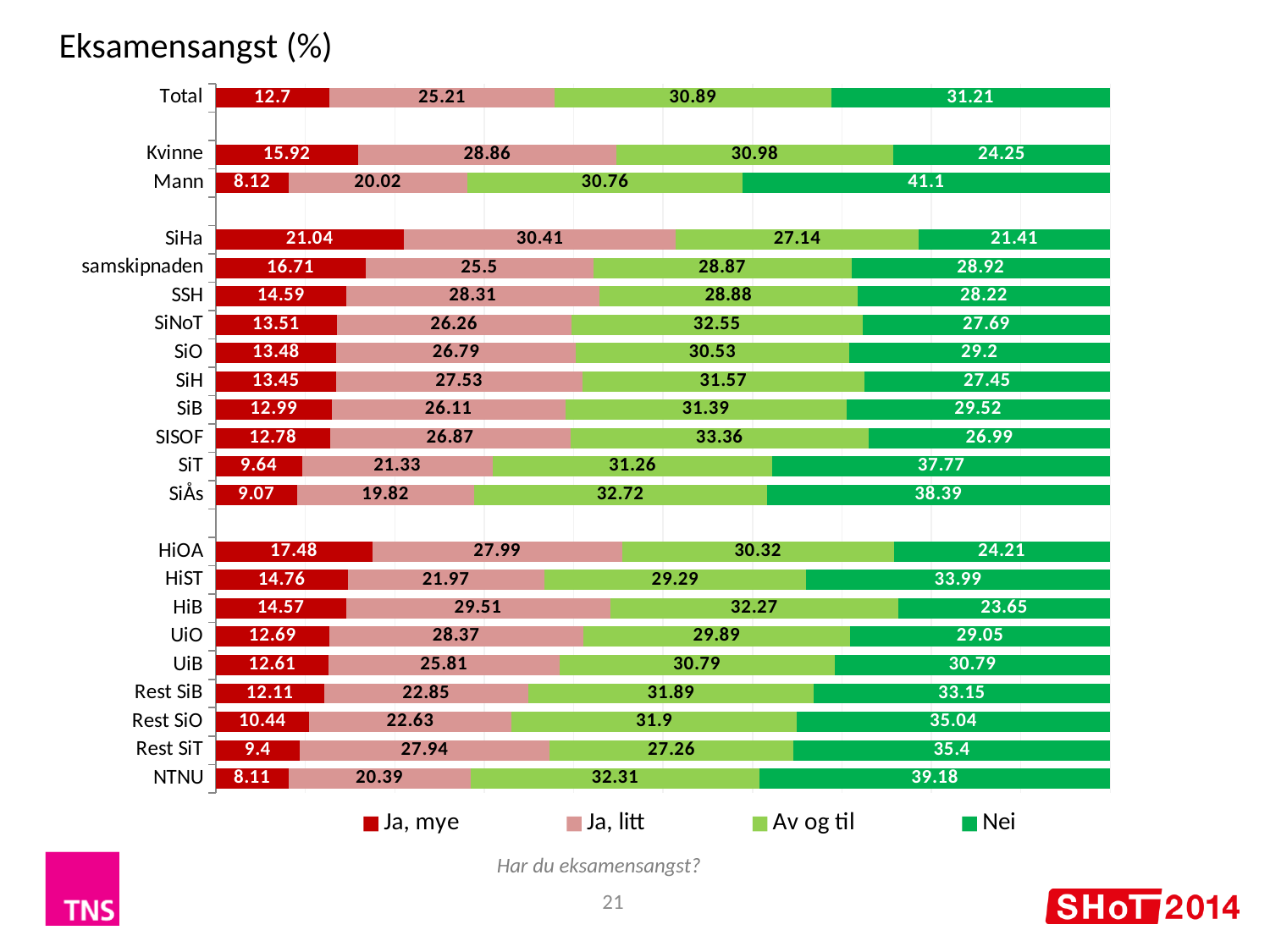
What is the value of "Nei" for Mann? 41.1 Which has a larger "Ja, mye" value, HiOA or HiST? HiOA How many categories are shown on the chart? 22 What is the value of "Ja, mye" for Total? 12.7 How many series does the legend list? 4 What is the difference between the "Ja, mye" values for Kvinne and Mann? 7.8 Which category has the lowest value for "Nei"? SiHa What is the total of the stacked bar for UiB? 100 Which category has the highest value for "Ja, mye"? SiHa What is the value of "Av og til" for NTNU? 32.31 Which category has the highest value for "Nei"? Mann What is the value of "Ja, litt" for SiHa? 30.41